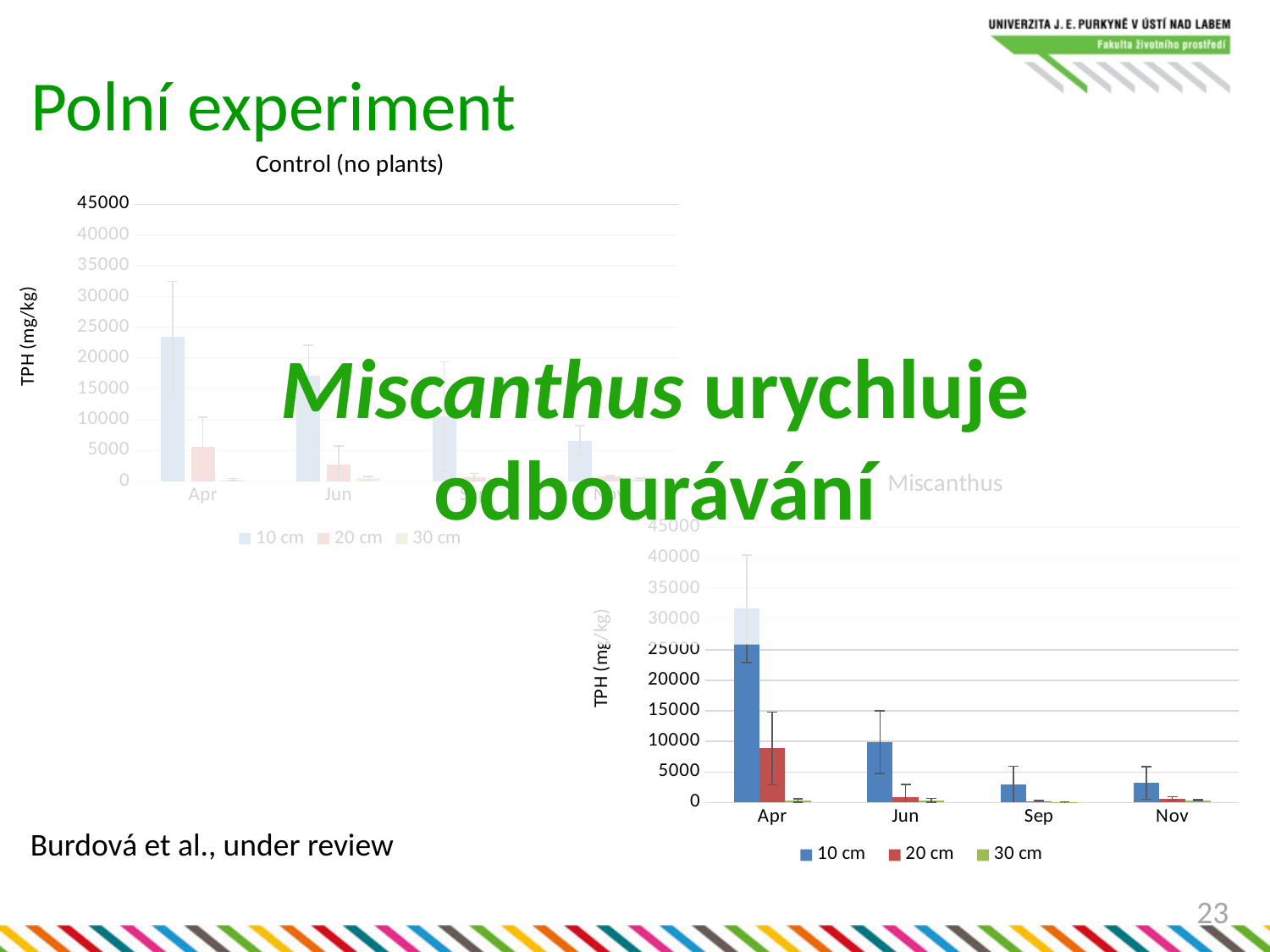
What is the y-axis label of the Control (no plants) chart? TPH (mg/kg) What kind of chart is the Miscanthus chart? bar chart In the Miscanthus chart, how many series does the legend list? 3 In the Miscanthus chart, do the 10 cm values rise or fall from Apr to Sep? fall In the Miscanthus chart, is the 10 cm value for Apr greater or less than 20000? greater In the Miscanthus chart, which month has the highest 10 cm value? Apr In the Miscanthus chart, how many months are shown on the x axis? 4 In the Control (no plants) chart, is the 10 cm value for Apr greater or less than 20000? greater In the Control (no plants) chart, which month has the larger 10 cm value: Apr or Jun? Apr In the Miscanthus chart, is the 10 cm value for Sep greater or less than 5000? less In the Miscanthus chart, for Apr, which is larger: the 10 cm value or the 20 cm value? 10 cm